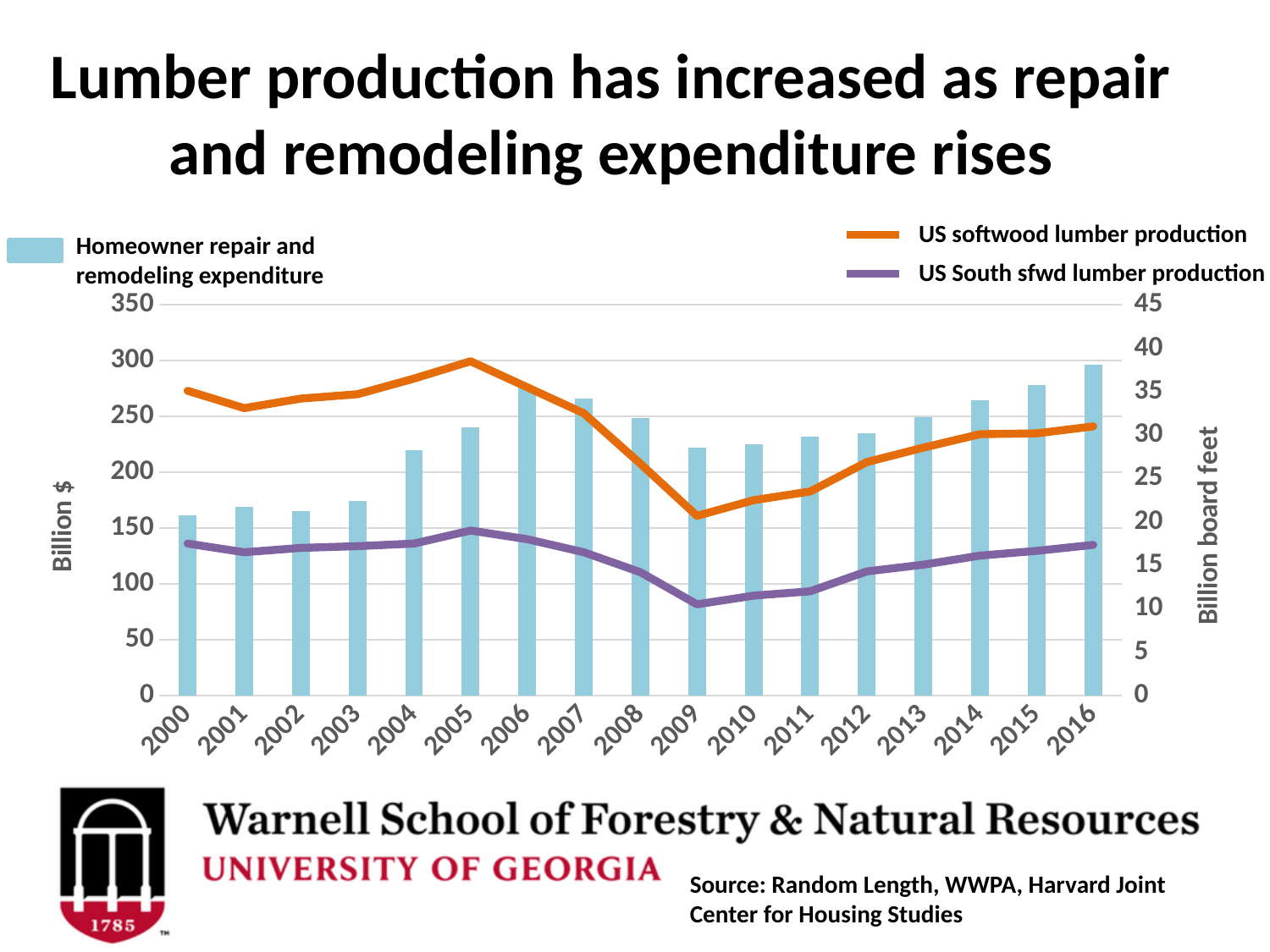
What is the label of the right-hand vertical axis? Billion board feet What kind of chart is shown on the slide? A combined bar and line chart In which year does the US softwood lumber production line reach its lowest point? 2009 In which year does the US South sfwd lumber production line reach its lowest point? 2009 In which year does the US softwood lumber production line reach its highest point? 2005 How many series do the chart's legends list in total? 3 Is the homeowner repair and remodeling expenditure for 2006 greater or less than 250 billion $? greater Which year has the larger homeowner repair and remodeling expenditure, 2004 or 2013? 2013 Is the US softwood lumber production value for 2009 greater or less than 25 billion board feet? less Is the homeowner repair and remodeling expenditure for 2000 greater or less than 200 billion $? less Does the US softwood lumber production line rise or fall between 2005 and 2009? fall How many years are shown along the x axis of the chart? 17